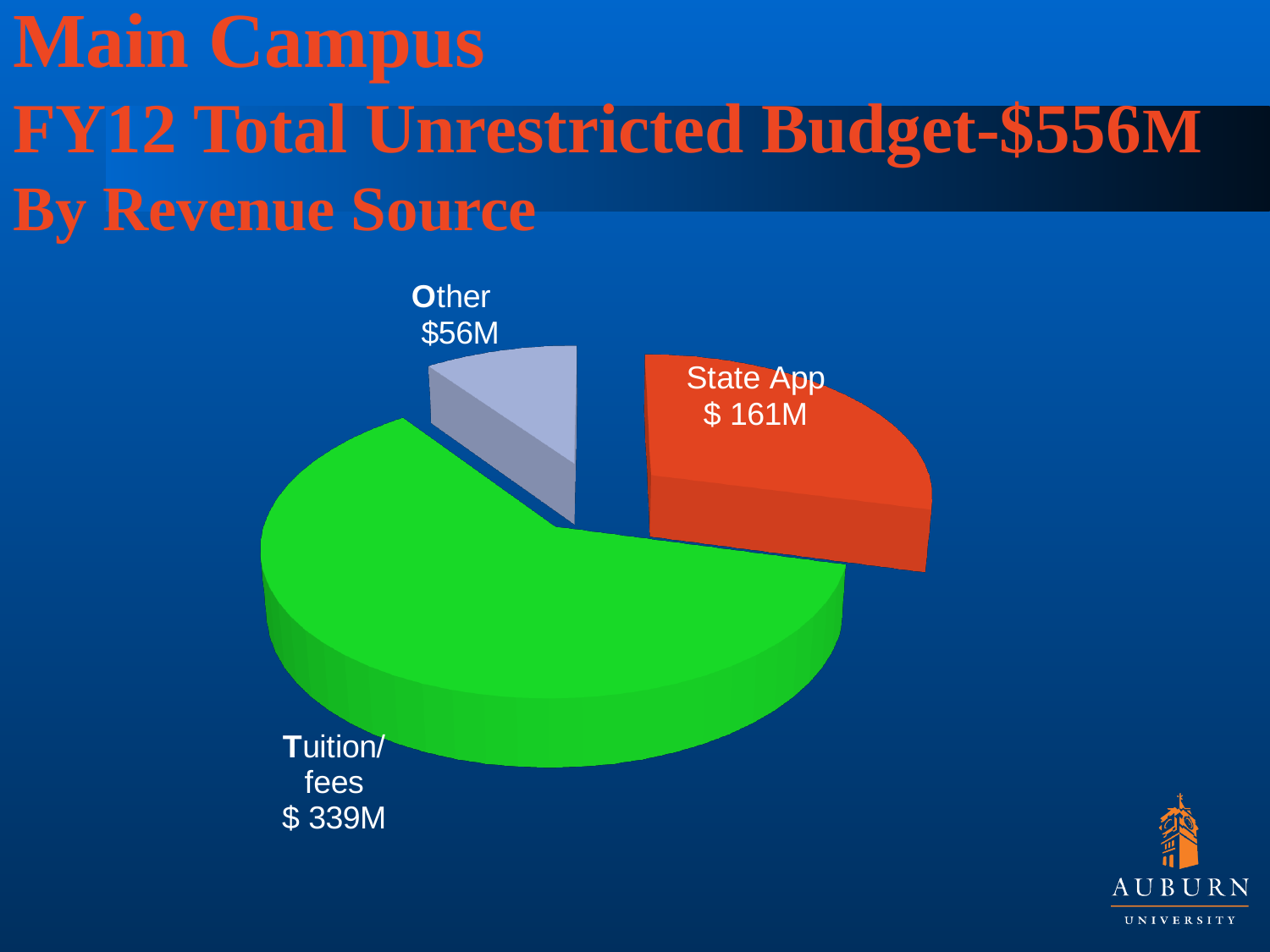
What is the difference between Tuition/fees and State App? $178M Which is larger, State App or Other? State App What type of chart is shown on the slide? pie chart What is the value for Other? $56M What is the total of all three slices? $556M What is the difference between State App and Other? $105M Which revenue source has the smallest slice? Other Which revenue source has the largest slice? Tuition/fees What is the value for State App? $ 161M What is the value for Tuition/fees? $ 339M What colour is the Tuition/fees slice? green How many slices does the pie chart have? 3